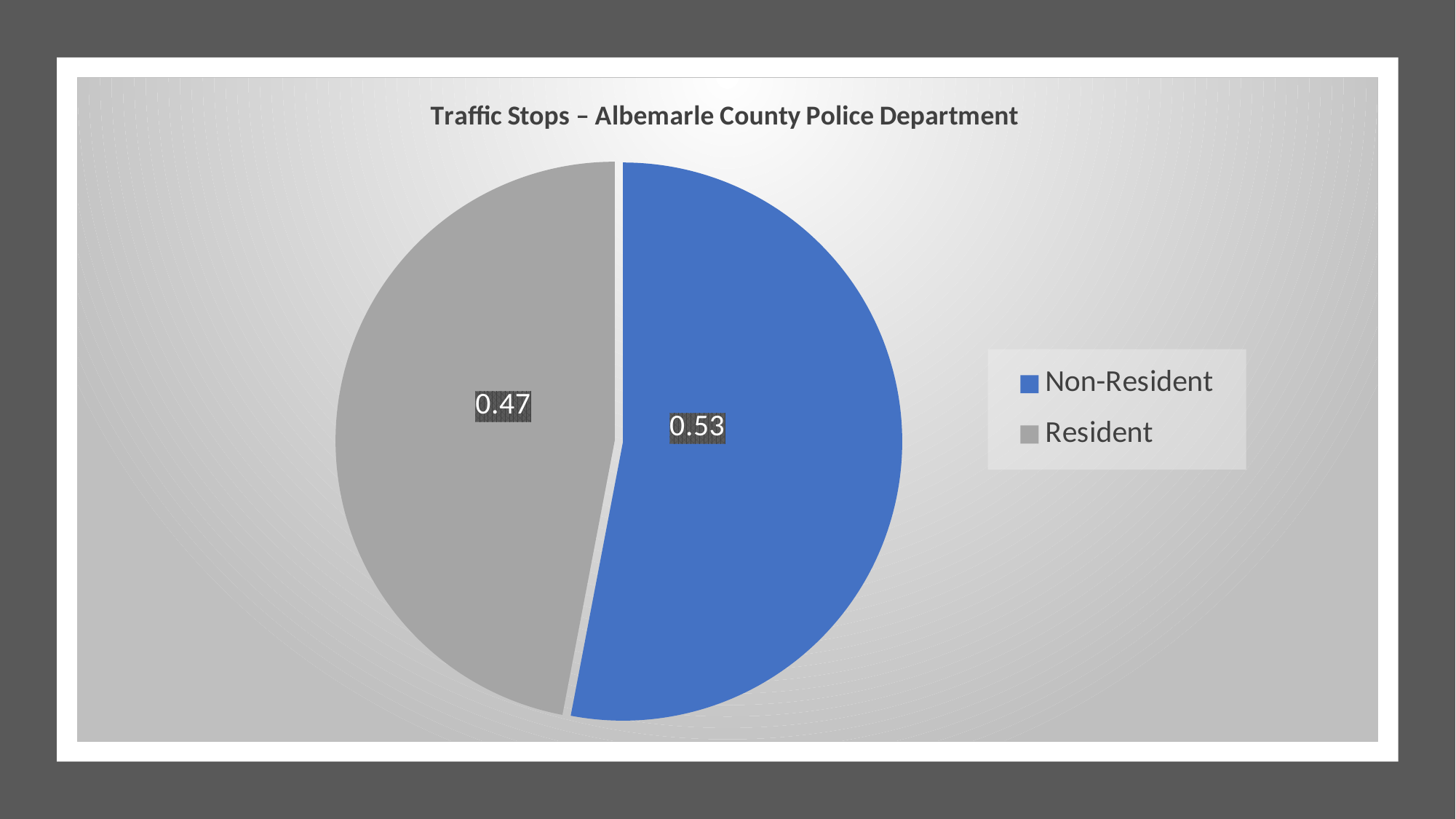
Which is larger, the Non-Resident value or the Resident value? Non-Resident How many slices does the pie chart have? 2 What is the difference between the Non-Resident and Resident values? 0.06 What is the value for Non-Resident? 0.53 What is the value for Resident? 0.47 What is the title of the chart? Traffic Stops – Albemarle County Police Department Which category has the largest slice? Non-Resident What kind of chart is shown on the slide? Pie chart Which category has the smallest slice? Resident What is the total of the two slice values shown? 1.00 What colour is the Non-Resident slice? Blue How many entries does the legend list? 2